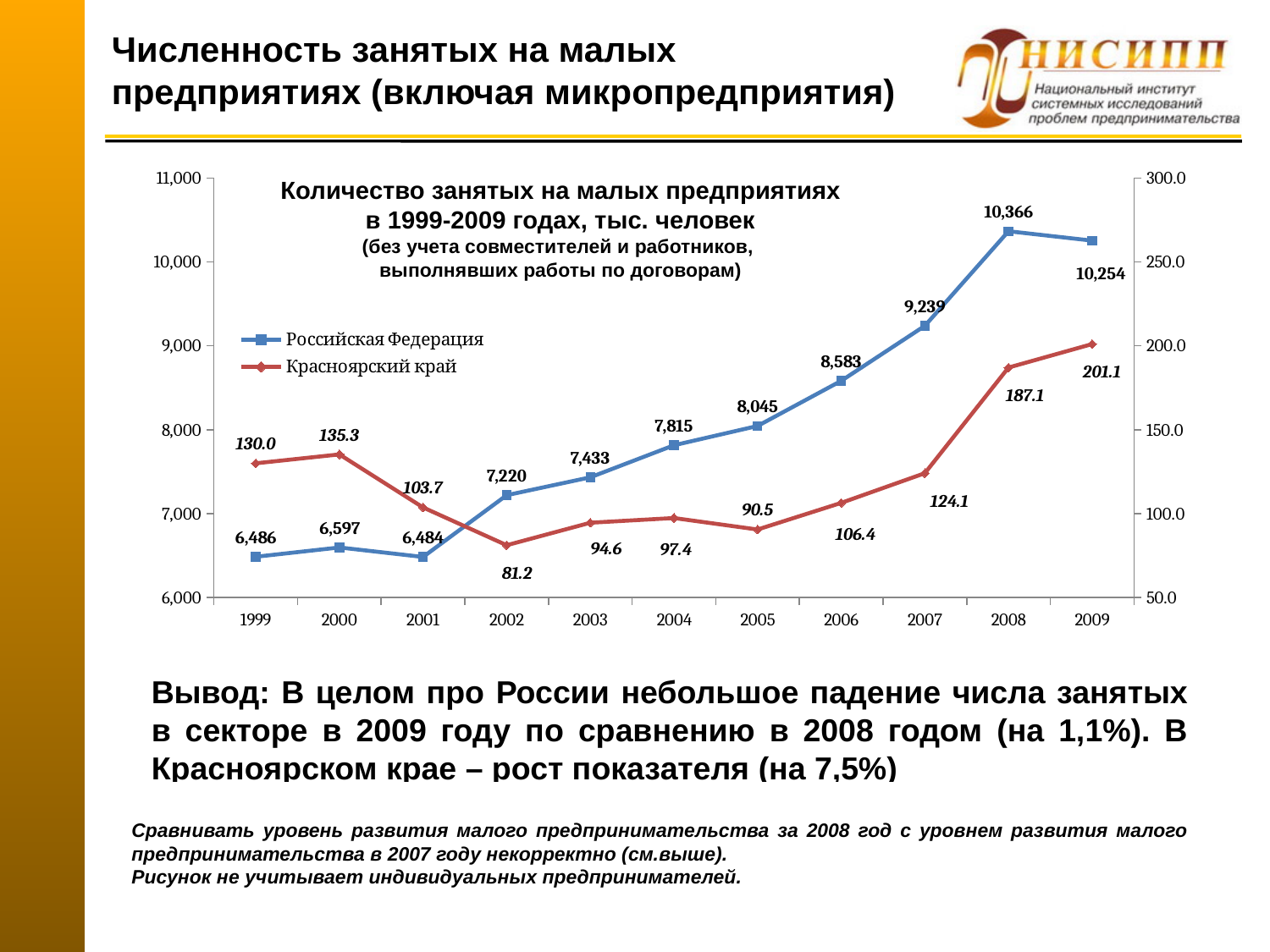
How many series does the legend list? 2 What is the value for Красноярский край in 2002? 81.2 What is the difference between the Российская Федерация values for 2008 and 2009? 112 Which series is drawn in red? Красноярский край How many years are plotted along the x axis? 11 What type of chart is shown on the slide? Line chart What is the value for Российская Федерация in 2008? 10,366 What is the value for Российская Федерация in 2004? 7,815 In which year is the value for Красноярский край the lowest? 2002 Which is larger for Красноярский край: the value in 2000 or the value in 2001? 2000 In which year is the value for Российская Федерация the highest? 2008 Does the Красноярский край series rise or fall from 2005 to 2009? Rise